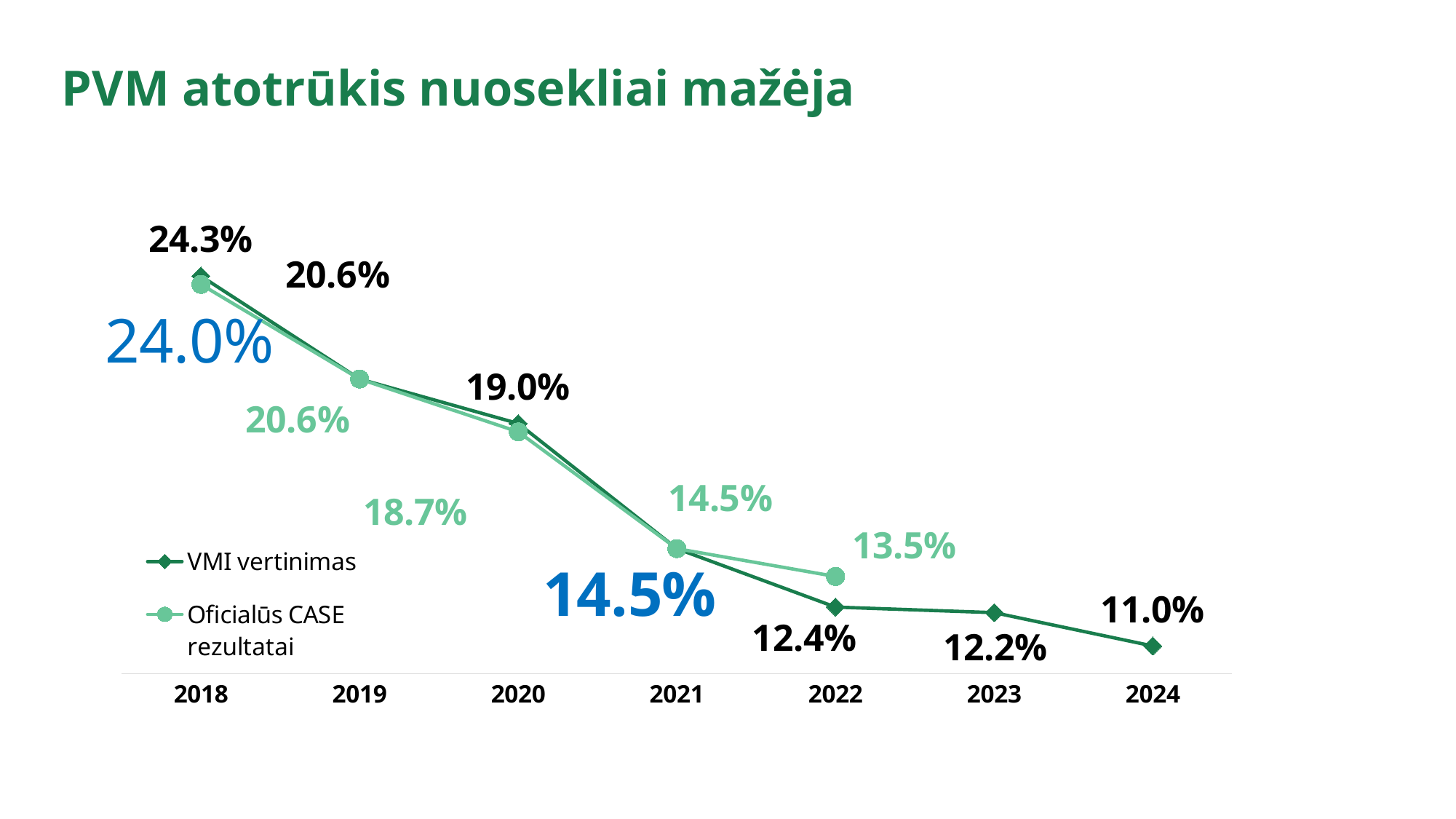
What is the Oficialūs CASE rezultatai value for 2019? 20.6% In which year is the VMI vertinimas value highest? 2018 Does the VMI vertinimas series rise or fall from 2018 to 2024? fall What is the difference between the VMI vertinimas values for 2018 and 2024? 13.3% How many series does the legend list? 2 What is the Oficialūs CASE rezultatai value for 2022? 13.5% What is the VMI vertinimas value for 2023? 12.2% In which year is the VMI vertinimas value lowest? 2024 What is the VMI vertinimas value for 2024? 11.0% What type of chart is shown on the slide? line chart Which is larger in 2022: the VMI vertinimas value or the Oficialūs CASE rezultatai value? Oficialūs CASE rezultatai What is the VMI vertinimas value for 2018? 24.3%